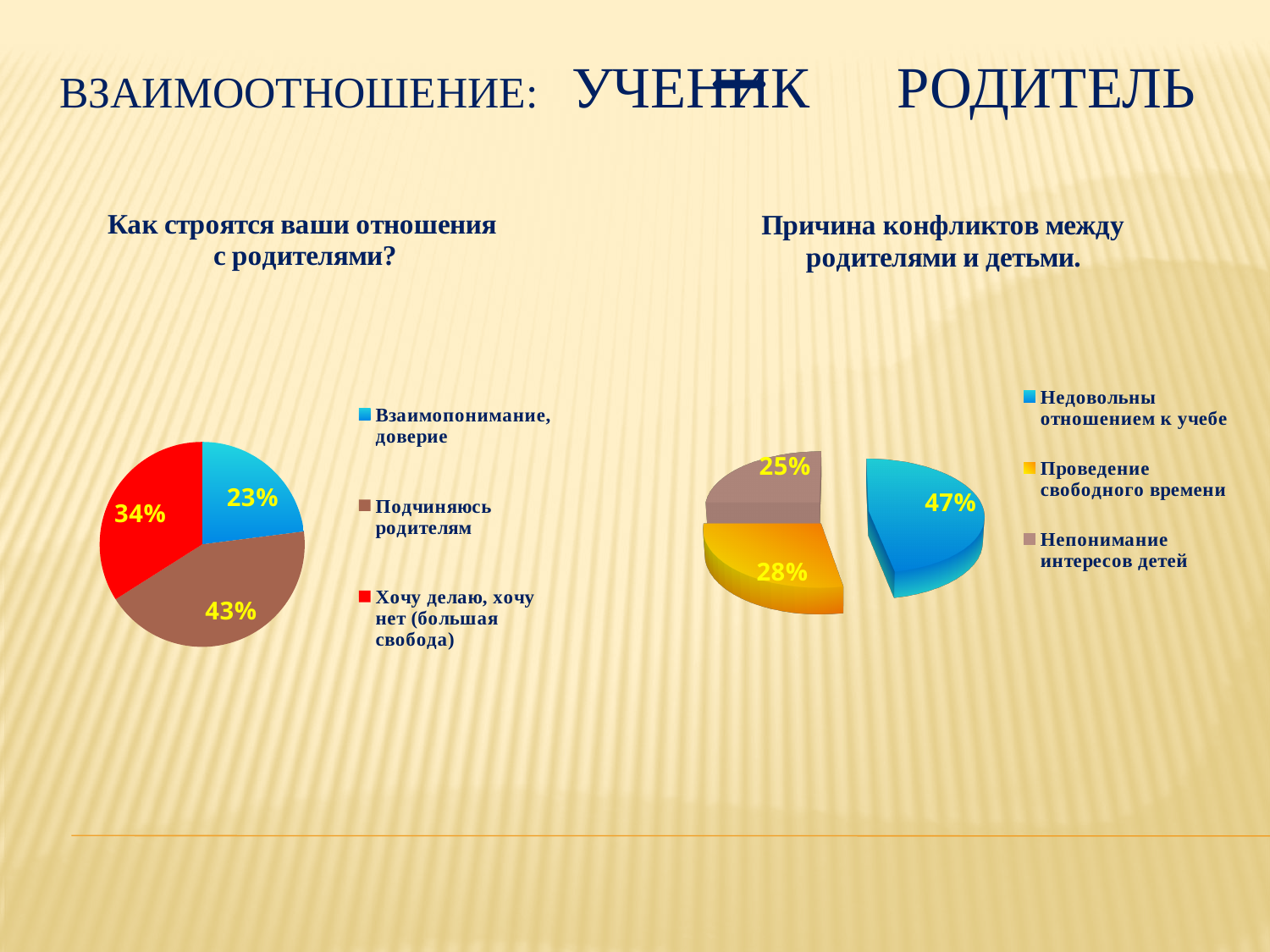
In the left chart 'Как строятся ваши отношения с родителями?', which category has the largest share? Подчиняюсь родителям In the right chart 'Причина конфликтов между родителями и детьми.', which category has the largest share? Недовольны отношением к учебе In the left chart 'Как строятся ваши отношения с родителями?', what is the difference between the shares for 'Подчиняюсь родителям' and 'Хочу делаю, хочу нет (большая свобода)'? 9% In the right chart 'Причина конфликтов между родителями и детьми.', what is the difference between 'Недовольны отношением к учебе' and 'Проведение свободного времени'? 19% How many slices does the left chart 'Как строятся ваши отношения с родителями?' have? 3 In the right chart 'Причина конфликтов между родителями и детьми.', what percentage is shown for 'Недовольны отношением к учебе'? 47% In the left chart 'Как строятся ваши отношения с родителями?', what percentage is shown for 'Взаимопонимание, доверие'? 23% In the right chart 'Причина конфликтов между родителями и детьми.', what percentage is shown for 'Непонимание интересов детей'? 25% In the right chart 'Причина конфликтов между родителями и детьми.', which is larger: 'Проведение свободного времени' or 'Непонимание интересов детей'? Проведение свободного времени What type of chart is the right chart 'Причина конфликтов между родителями и детьми.'? Pie chart In the left chart 'Как строятся ваши отношения с родителями?', which category has the smallest share? Взаимопонимание, доверие In the left chart 'Как строятся ваши отношения с родителями?', what percentage is shown for 'Подчиняюсь родителям'? 43%